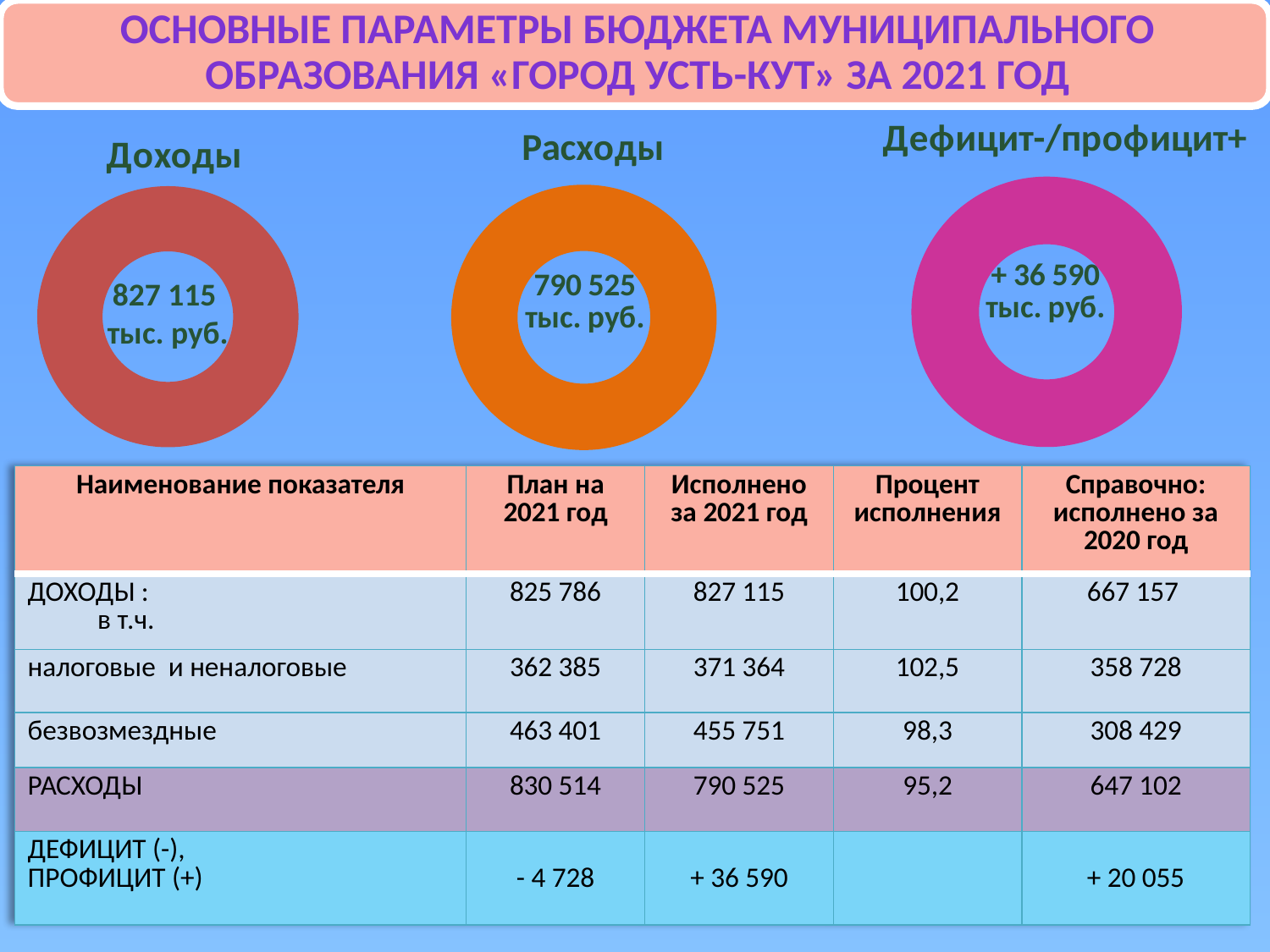
Which is larger, the value in the "Доходы" chart or the value in the "Расходы" chart? Доходы What value is shown in the centre of the "Дефицит-/профицит+" donut chart? + 36 590 тыс. руб. What value is shown in the centre of the "Расходы" donut chart? 790 525 тыс. руб. What value is shown in the centre of the "Доходы" donut chart? 827 115 тыс. руб. What colour is the ring of the "Дефицит-/профицит+" donut chart? Magenta (pink) How many donut charts are shown on the slide? 3 What colour is the ring of the "Расходы" donut chart? Orange What kind of chart is used for "Доходы", "Расходы" and "Дефицит-/профицит+"? Donut chart Which of the three donut charts shows the largest value? Доходы Which of the three donut charts shows the smallest value? Дефицит-/профицит+ What is the difference between the value in the "Доходы" chart and the value in the "Расходы" chart? 36 590 тыс. руб.